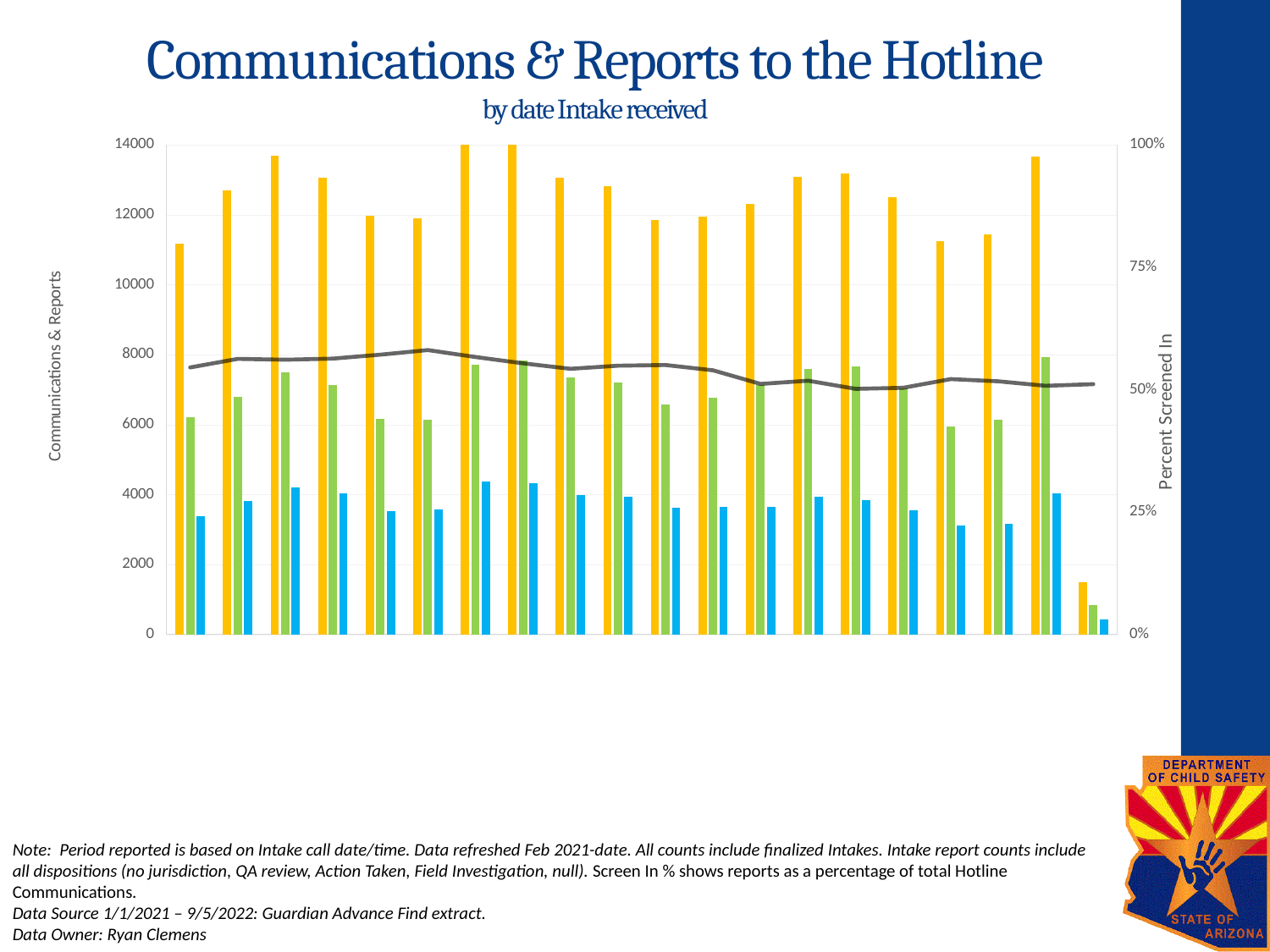
What is the title of the chart on the slide? Communications & Reports to the Hotline Is the grey line's value greater or less than 75% across the chart? less What is the label on the right-hand vertical axis of the chart? Percent Screened In Is the grey line's value greater or less than 25% across the chart? greater Within each group of bars, which colour bar is the tallest: yellow, green or blue? yellow How many groups of bars are plotted along the x axis of the chart? 20 Is the tallest yellow bar on the chart greater or less than 12000? greater Does the grey line rise sharply, fall sharply, or stay roughly flat across the x axis? roughly flat What kind of chart is shown on the slide? bar chart with a line